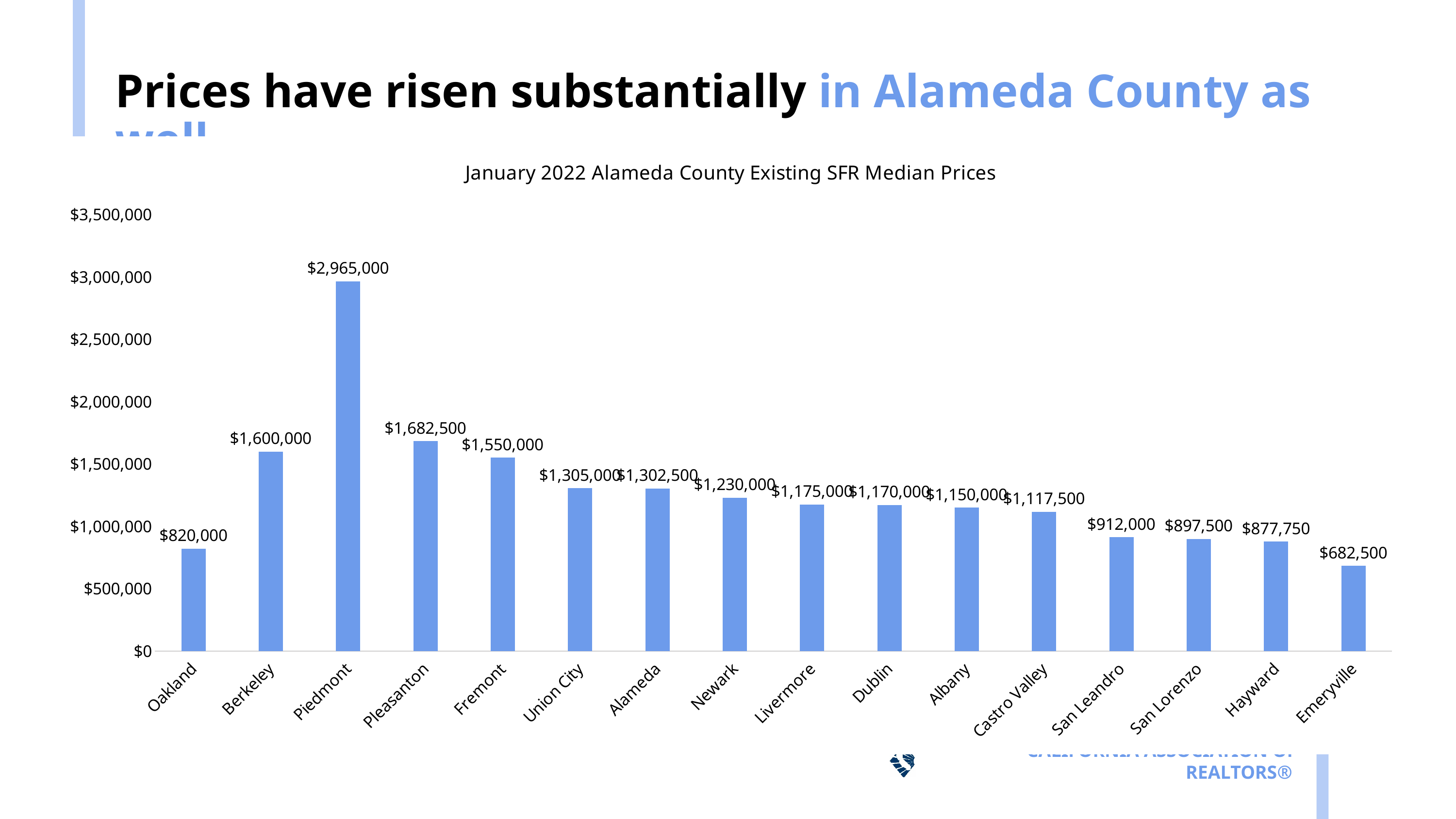
Which has a higher median price, Berkeley or Pleasanton? Pleasanton Which city has the highest median price? Piedmont What kind of chart is shown on the slide? bar chart What is the median price for Castro Valley? $1,117,500 What is the median price for Piedmont? $2,965,000 How many cities are shown on the chart? 16 What is the difference between the median prices of San Leandro and Emeryville? $229,500 What is the difference between the median prices of Pleasanton and Fremont? $132,500 What is the median price for Oakland? $820,000 Which city has the lowest median price? Emeryville Is the value for Hayward greater or less than $1,000,000? less What is the title of the chart? January 2022 Alameda County Existing SFR Median Prices